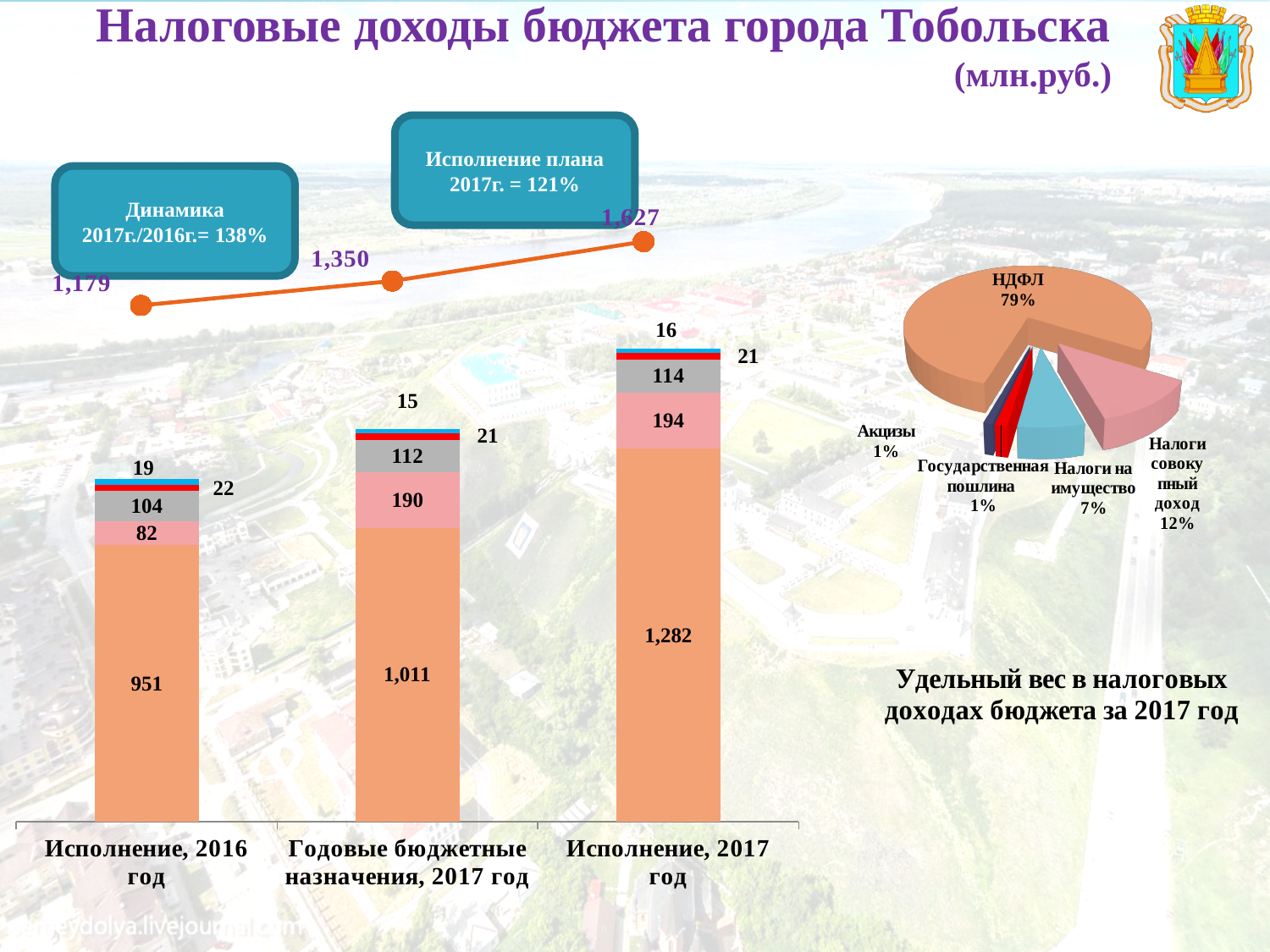
In the pie chart, which slice is the largest? НДФЛ In the stacked bar chart, what is the difference between the bottom orange segment for 'Исполнение, 2017 год' and for 'Исполнение, 2016 год'? 331 In the pie chart, what share does 'НДФЛ' have? 79% In the stacked bar chart, what is the value of the pink segment for 'Исполнение, 2016 год'? 82 What kind of chart is the one on the left of the slide? bar chart In the stacked bar chart, do the values on the orange line rise or fall from left to right? rise In the stacked bar chart, which has the larger grey segment: 'Исполнение, 2017 год' or 'Годовые бюджетные назначения, 2017 год'? Исполнение, 2017 год In the stacked bar chart, what value does the orange line show for 'Годовые бюджетные назначения, 2017 год'? 1,350 How many categories are shown on the x axis of the stacked bar chart? 3 In the stacked bar chart, which category has the highest value on the orange line? Исполнение, 2017 год In the stacked bar chart, what is the value of the bottom orange segment for 'Исполнение, 2017 год'? 1,282 In the pie chart, what share does 'Налоги на имущество' have? 7%